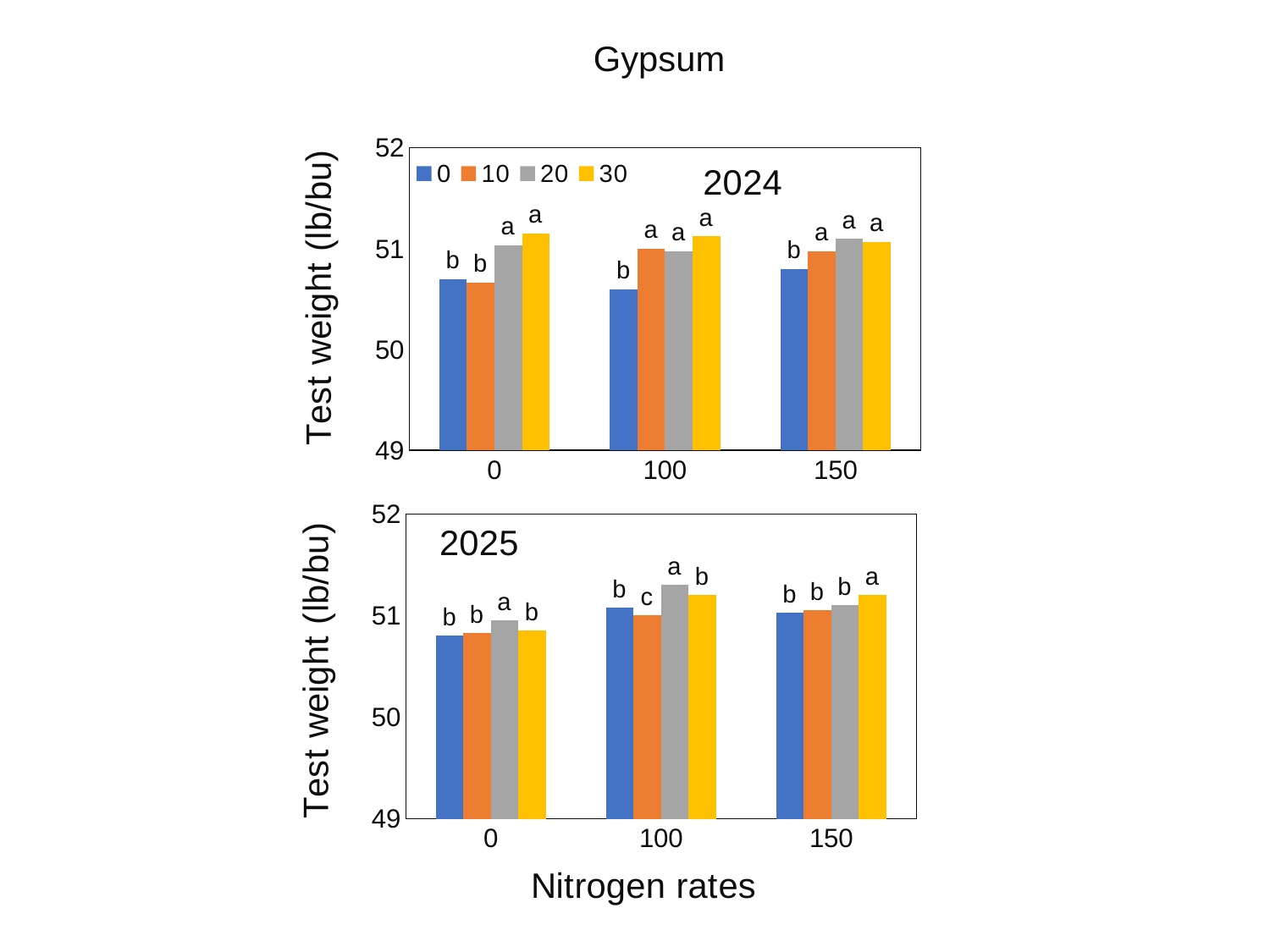
What kind of chart is the 2024 chart? bar chart In the 2025 chart, at nitrogen rate 100, which series has the highest test weight? 20 What is the y-axis label of the 2025 chart? Test weight (lb/bu) How many nitrogen rate categories are shown on the x axis of the 2025 chart? 3 How many series does the legend of the 2024 chart list? 4 In the 2024 chart, is the value for the 30 series at nitrogen rate 0 greater or less than 51? greater In the 2025 chart, is the value for the 20 series at nitrogen rate 100 greater or less than 51? greater In the 2024 chart, at nitrogen rate 100, which series has the lowest test weight? 0 In the 2024 chart, at nitrogen rate 0, which is larger: the value for the 30 series or the 0 series? 30 In the 2025 chart, is the value for the 0 series at nitrogen rate 0 greater or less than 51? less What is the title shown above the charts? Gypsum